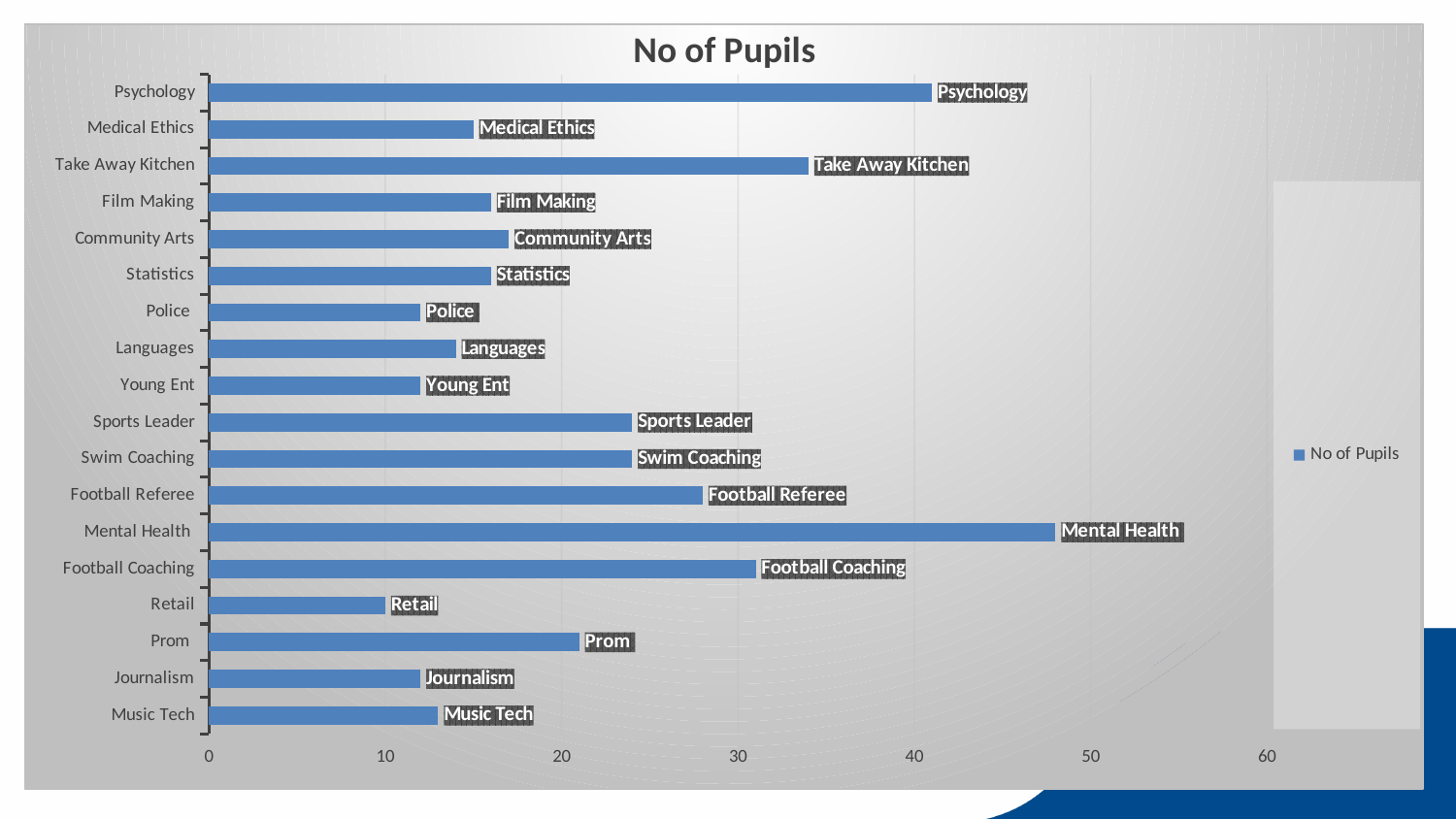
Which category has the lowest number of pupils? Retail Which category has the highest number of pupils? Mental Health Which has more pupils, Psychology or Take Away Kitchen? Psychology Is the value for Mental Health greater or less than 40? greater How many categories are plotted in the chart? 18 Which has more pupils, Football Coaching or Football Referee? Football Coaching What kind of chart is shown on the slide? bar chart How many series does the legend list? 1 Is the value for Take Away Kitchen greater or less than 40? less Is the value for Medical Ethics greater or less than 20? less What is the title of the chart? No of Pupils